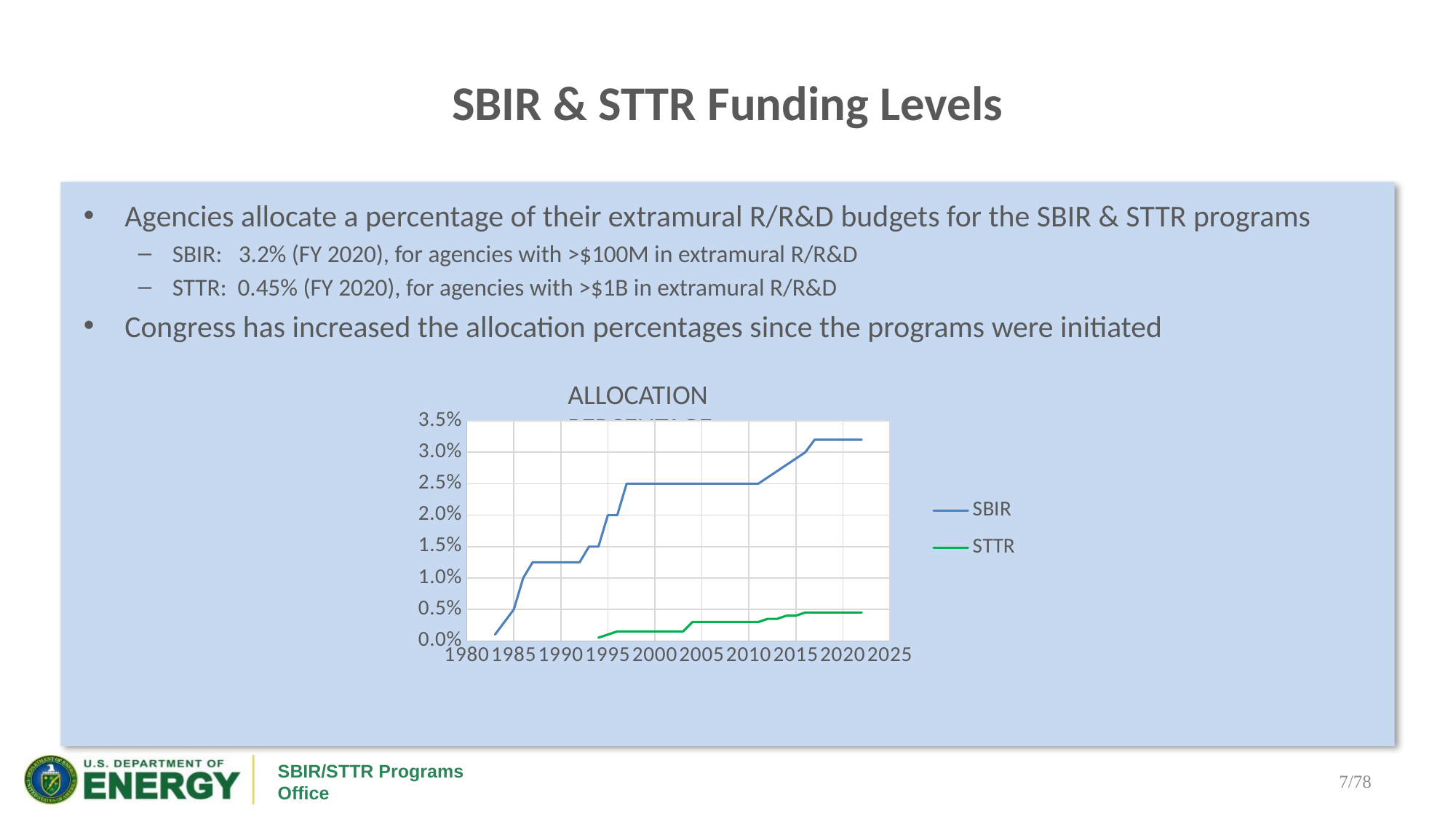
Is the SBIR allocation percentage in 1990 greater or less than 1.0%? greater Is the STTR allocation percentage in 2000 greater or less than 0.5%? less What are the two series named in the chart's legend? SBIR and STTR What kind of chart is shown on the slide? line chart At what allocation percentage does the SBIR line plateau between roughly 1997 and 2011? 2.5% How many series does the chart's legend list? 2 Is the SBIR allocation percentage in 2005 greater or less than 2.0%? greater Does the SBIR allocation percentage rise or fall over time along the x axis? rise Which series has the higher allocation percentage in 2020, SBIR or STTR? SBIR Does the STTR allocation percentage rise or fall over time along the x axis? rise